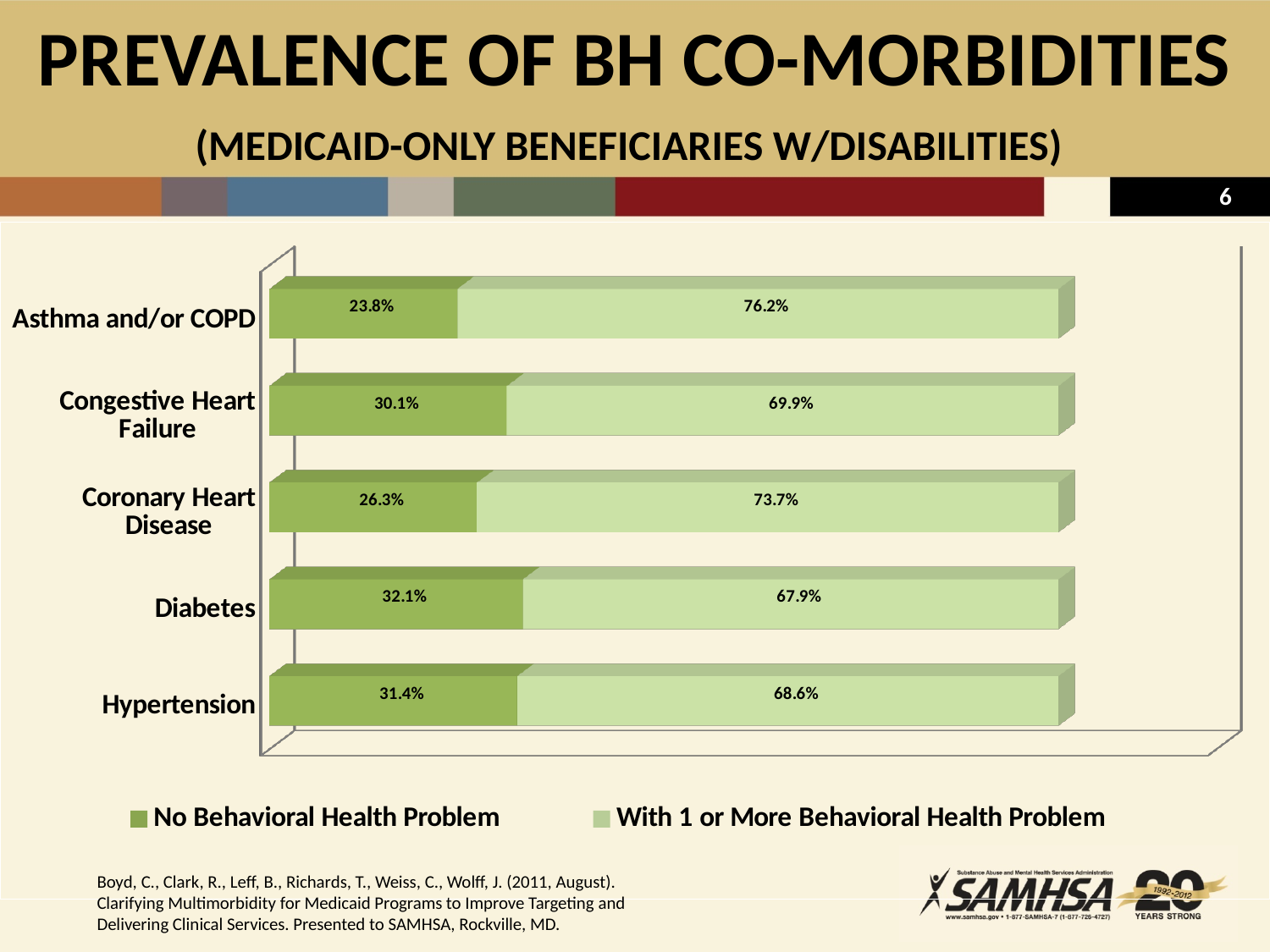
What is the value for "No Behavioral Health Problem" for Congestive Heart Failure? 30.1% What is the difference between the "With 1 or More Behavioral Health Problem" value for Asthma and/or COPD and for Coronary Heart Disease? 2.5% Which is larger: the "No Behavioral Health Problem" value for Hypertension or for Coronary Heart Disease? Hypertension What kind of chart is shown on the slide? Stacked bar chart What is the value for "With 1 or More Behavioral Health Problem" for Hypertension? 68.6% How many series does the legend list? 2 Which category has the lowest value for "With 1 or More Behavioral Health Problem"? Diabetes Which category has the lowest value for "No Behavioral Health Problem"? Asthma and/or COPD What is the value for "With 1 or More Behavioral Health Problem" for Asthma and/or COPD? 76.2% How many categories are shown in the chart? 5 What is the value for "No Behavioral Health Problem" for Diabetes? 32.1% Which category has the highest value for "No Behavioral Health Problem"? Diabetes